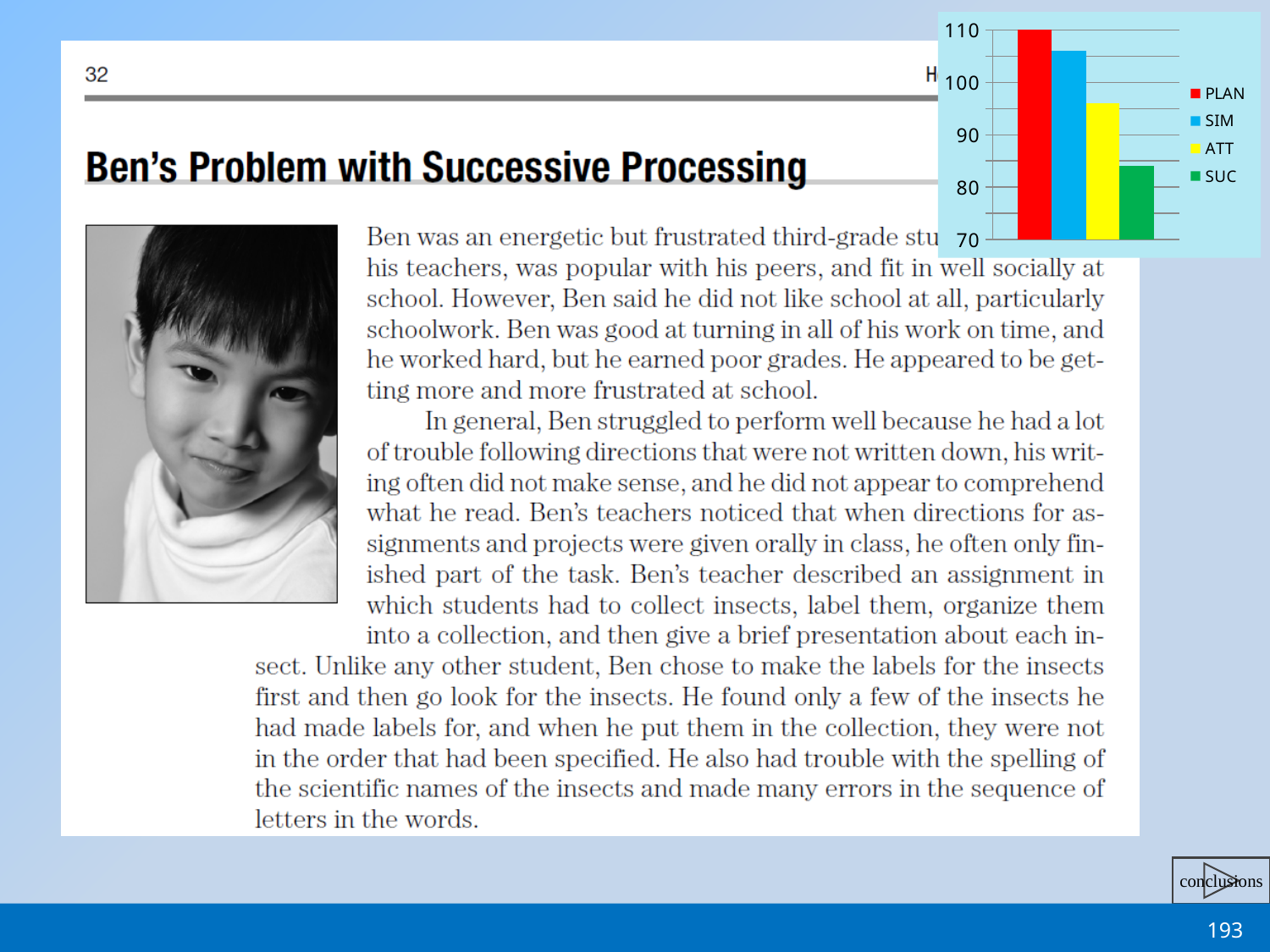
Is the value for ATT greater or less than 90? greater Which is larger in the chart, ATT or SUC? ATT Which series has the lowest bar in the chart? SUC Is the value for SIM greater or less than 100? greater Do the bars rise or fall from left to right across the chart? fall Which is larger in the chart, SIM or ATT? SIM What kind of chart is shown in the top right of the slide? bar chart Which series is shown in green in the chart legend? SUC Which series has the highest bar in the chart? PLAN What colour is the PLAN bar in the chart? red Is the value for SUC greater or less than 90? less How many series does the chart legend list? 4